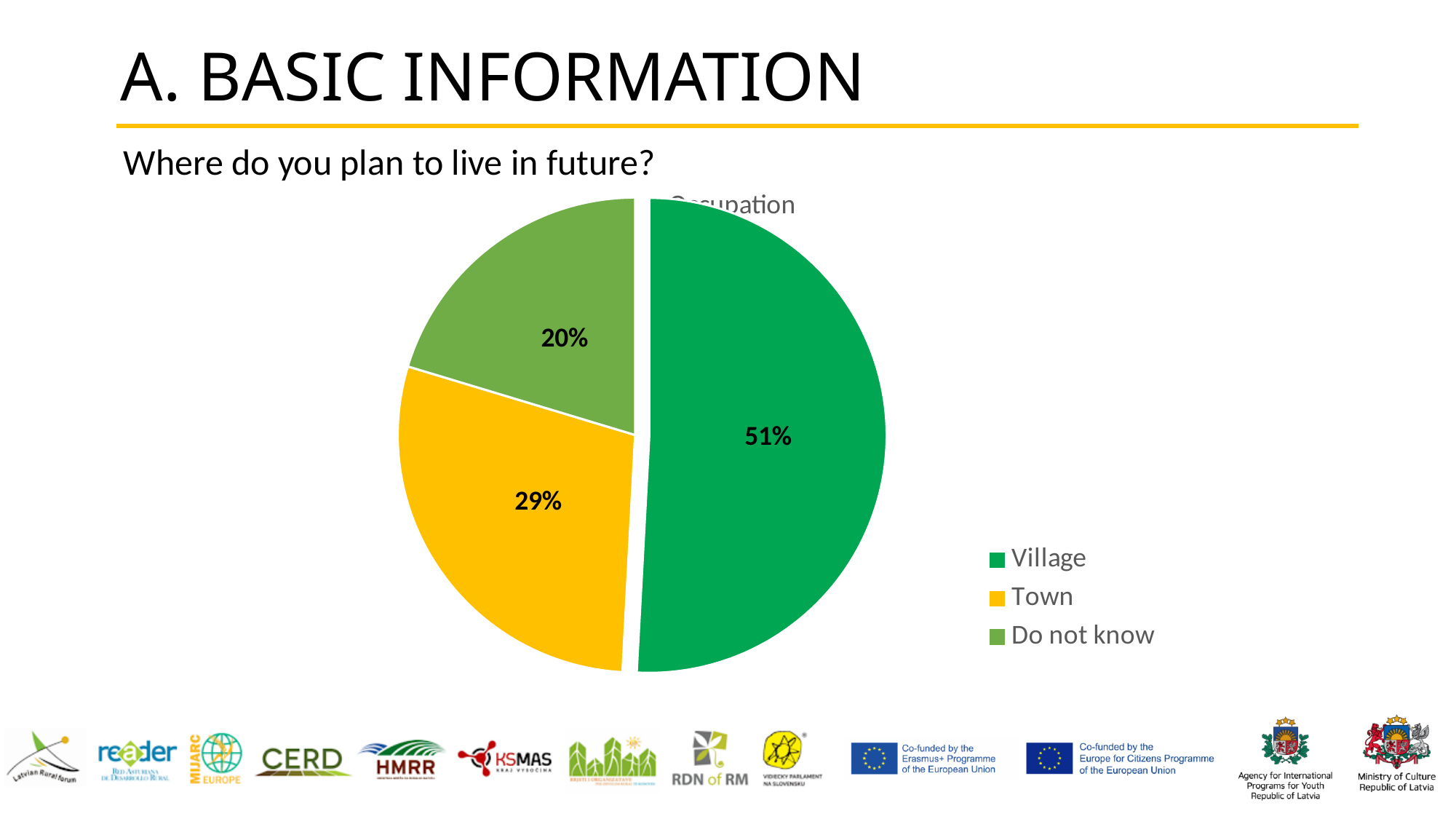
How many categories does the pie chart show? 3 Which slice is larger, Town or Do not know? Town What share of the pie chart is labelled Village? 51% What colour is the Town slice in the pie chart? Yellow What question does the chart on the slide answer? Where do you plan to live in future? Which category has the smallest slice of the pie chart? Do not know Which category has the largest slice of the pie chart? Village What is the difference in percentage points between the Village and Town slices? 22 What is the difference in percentage points between the Town and Do not know slices? 9 What kind of chart is shown on the slide? Pie chart What share of the pie chart is labelled Town? 29% What share of the pie chart is labelled Do not know? 20%